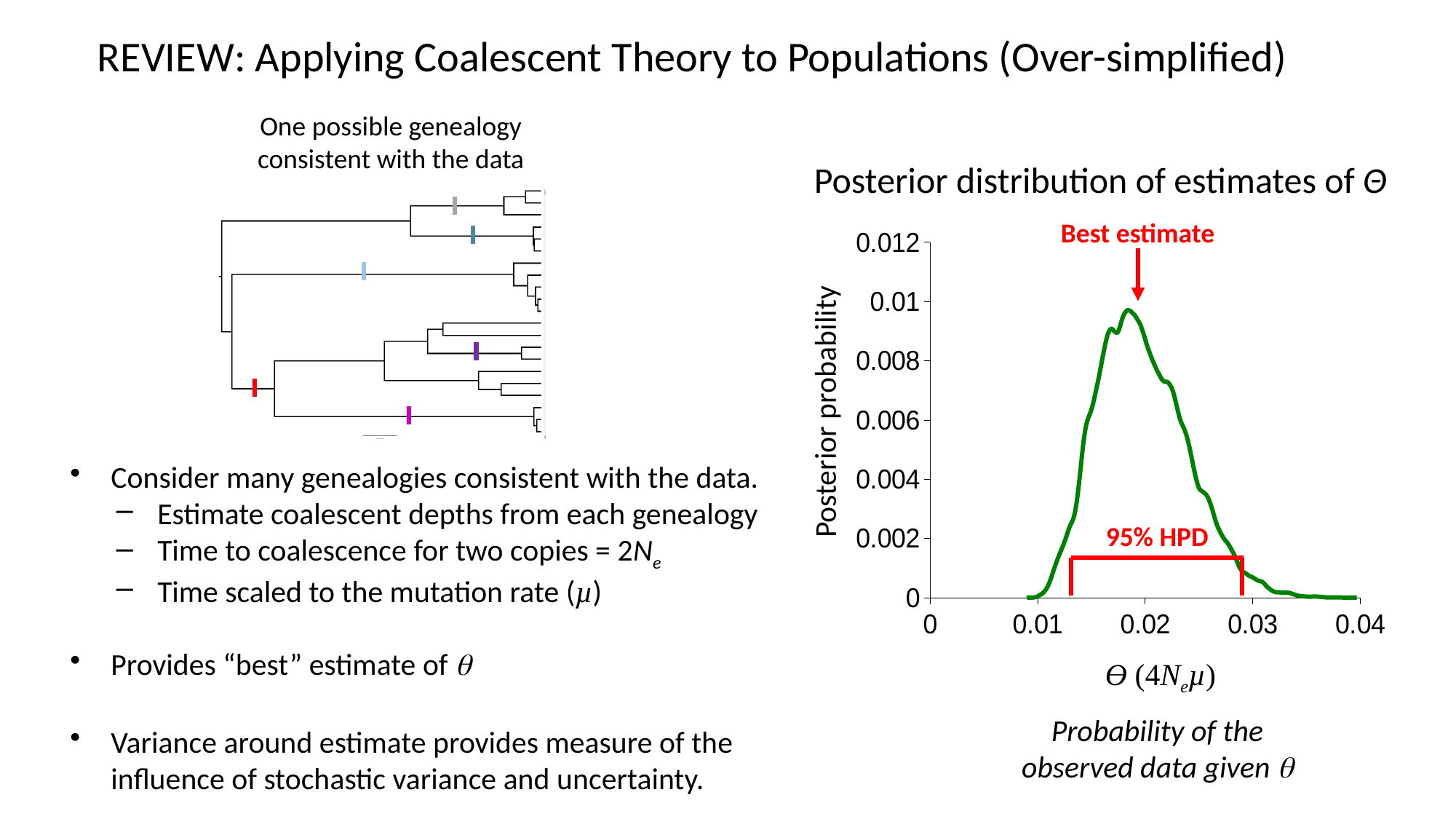
What kind of chart is shown on the right side of the slide? line chart In the posterior distribution chart, what does the red bracket near the bottom of the curve represent? 95% HPD In the posterior distribution chart, is the posterior probability at Θ = 0.01 greater or less than 0.002? less In the posterior distribution chart, does the curve rise or fall as Θ increases from 0.02 to 0.04? fall In the posterior distribution chart, what is the highest value shown on the y axis? 0.012 In the posterior distribution chart, is the posterior probability at Θ = 0.03 greater or less than 0.004? less In the posterior distribution chart, what is the label of the y axis? Posterior probability In the posterior distribution chart, how many tick labels are shown on the x axis? 5 In the posterior distribution chart, what is the highest value shown on the x axis? 0.04 In the posterior distribution chart, is the posterior probability at Θ = 0.02 greater or less than 0.006? greater What is the title of the chart on the right side of the slide? Posterior distribution of estimates of Θ